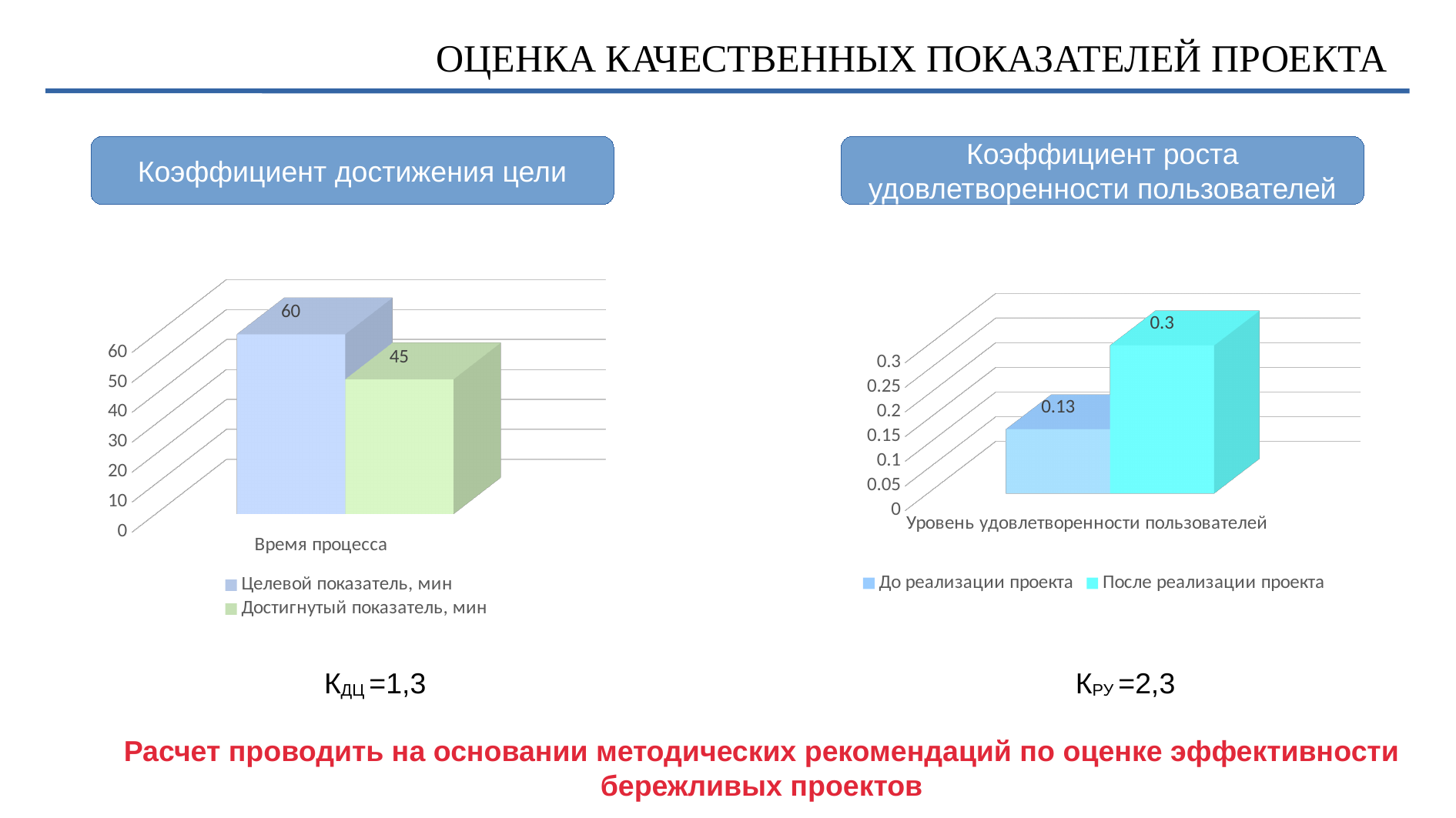
In the left chart (Коэффициент достижения цели), how many series does the legend list? 2 In the right chart (Коэффициент роста удовлетворенности пользователей), what is the value for После реализации проекта? 0.3 In the left chart (Коэффициент достижения цели), what is the difference between Целевой показатель, мин and Достигнутый показатель, мин? 15 In the right chart (Коэффициент роста удовлетворенности пользователей), is the value for До реализации проекта greater or less than 0.15? less In the right chart (Коэффициент роста удовлетворенности пользователей), what is the value for До реализации проекта? 0.13 What kind of chart is the right chart (Коэффициент роста удовлетворенности пользователей)? Bar chart In the left chart (Коэффициент достижения цели), what is the value for Достигнутый показатель, мин? 45 In the left chart (Коэффициент достижения цели), which series has the larger value: Целевой показатель, мин or Достигнутый показатель, мин? Целевой показатель, мин In the left chart (Коэффициент достижения цели), what is the value for Целевой показатель, мин? 60 In the right chart (Коэффициент роста удовлетворенности пользователей), which series has the higher value? После реализации проекта In the right chart (Коэффициент роста удовлетворенности пользователей), how many series does the legend list? 2 In the left chart (Коэффициент достижения цели), what is the category label on the x axis? Время процесса